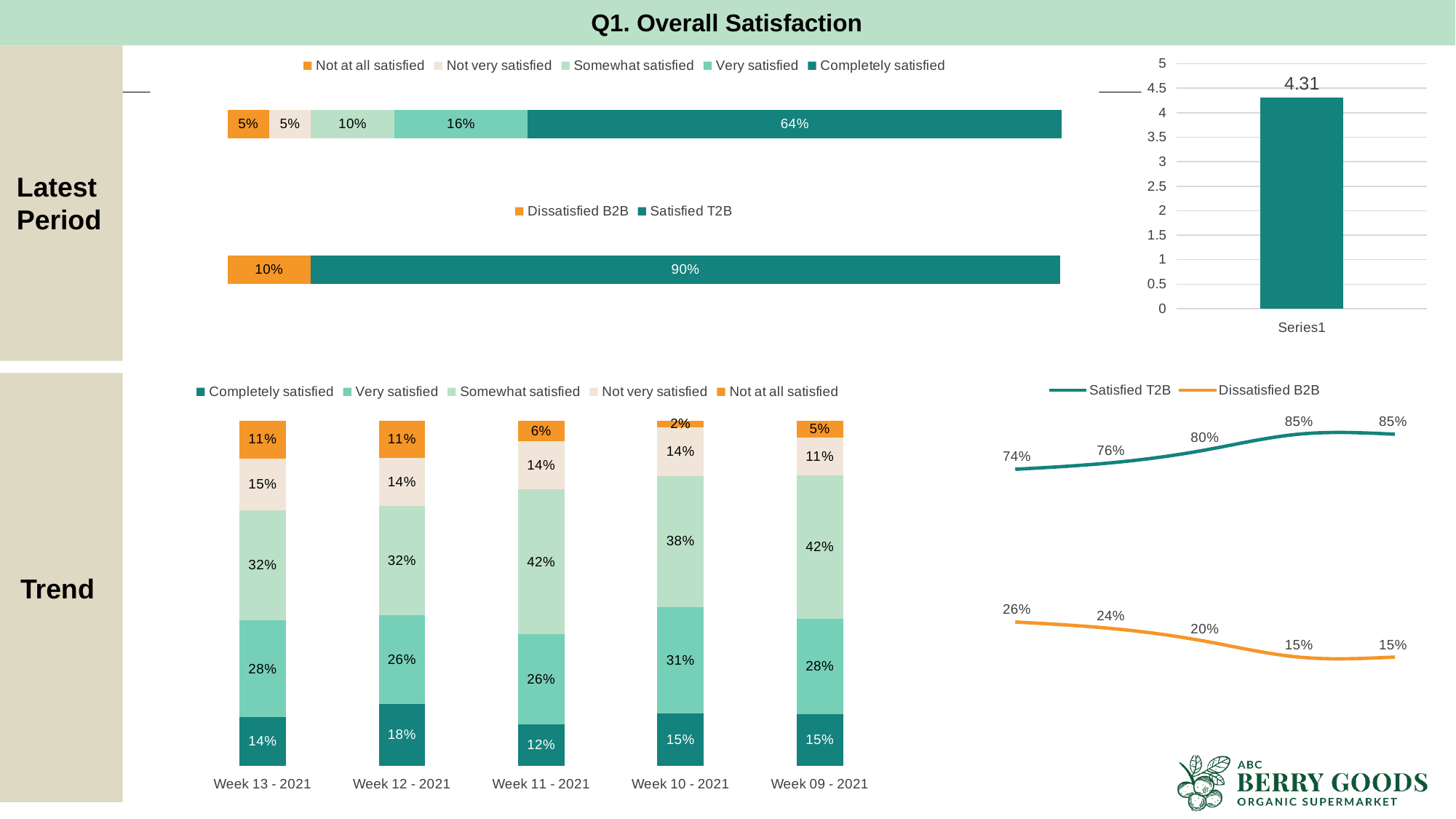
In the Trend stacked bar chart at the bottom left, what is the Completely satisfied value for Week 12 - 2021? 18% In the Trend stacked bar chart at the bottom left, which week has the highest Completely satisfied value? Week 12 - 2021 In the Trend line chart at the bottom right, how many series does the legend list? 2 In the Trend line chart at the bottom right, what is the difference between the highest Dissatisfied B2B value (26%) and the lowest (15%)? 11% In the Latest Period Dissatisfied B2B / Satisfied T2B bar chart, what is the Satisfied T2B value? 90% In the Latest Period Dissatisfied B2B / Satisfied T2B bar chart, what is the difference between Satisfied T2B and Dissatisfied B2B? 80% In the Latest Period stacked bar chart at the top left, what percentage is Completely satisfied? 64% In the Latest Period stacked bar chart at the top left, what percentage is Very satisfied? 16% In the Trend stacked bar chart at the bottom left, how many weeks are shown on the x axis? 5 In the Trend stacked bar chart at the bottom left, what is the Somewhat satisfied value for Week 11 - 2021? 42% In the bar chart at the top right of the slide, what value is shown for Series1? 4.31